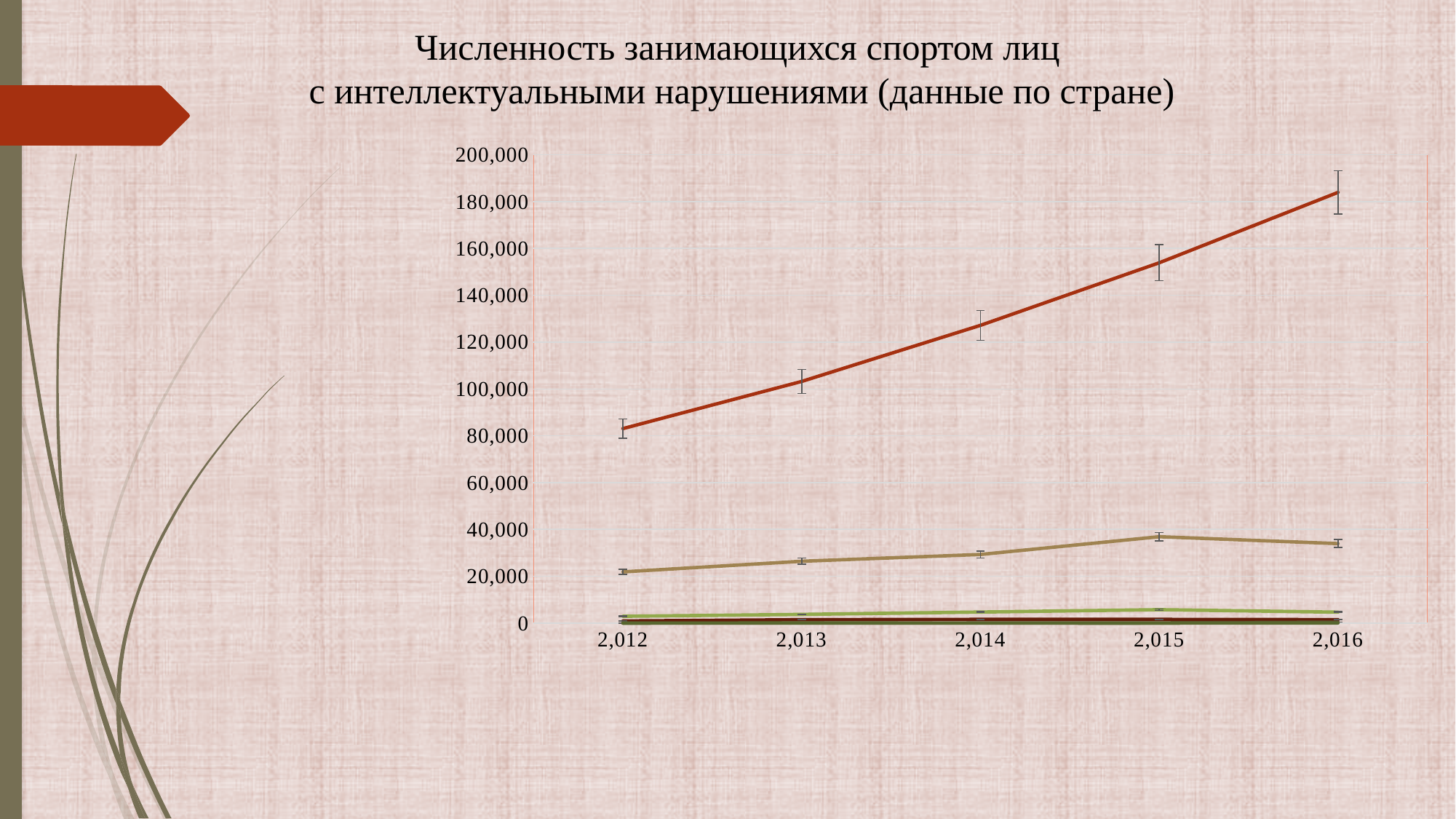
Is the value of the second (tan) line in 2,015 greater or less than 60,000? less How many years are shown along the x axis? 5 Is the value of the top (red) line in 2,012 greater or less than 100,000? less In which year does the top (red) line reach its highest value? 2,016 Does the top (red) line rise or fall from 2,012 to 2,016? rise Which years does the x axis cover? 2,012 to 2,016 Which is larger for the top (red) line: the value in 2,013 or the value in 2,015? 2,015 Is the value of the top (red) line in 2,014 greater or less than 100,000? greater In which year does the top (red) line have its lowest value? 2,012 What is the title of the chart? Численность занимающихся спортом лиц с интеллектуальными нарушениями (данные по стране) What kind of chart is shown on the slide? line chart